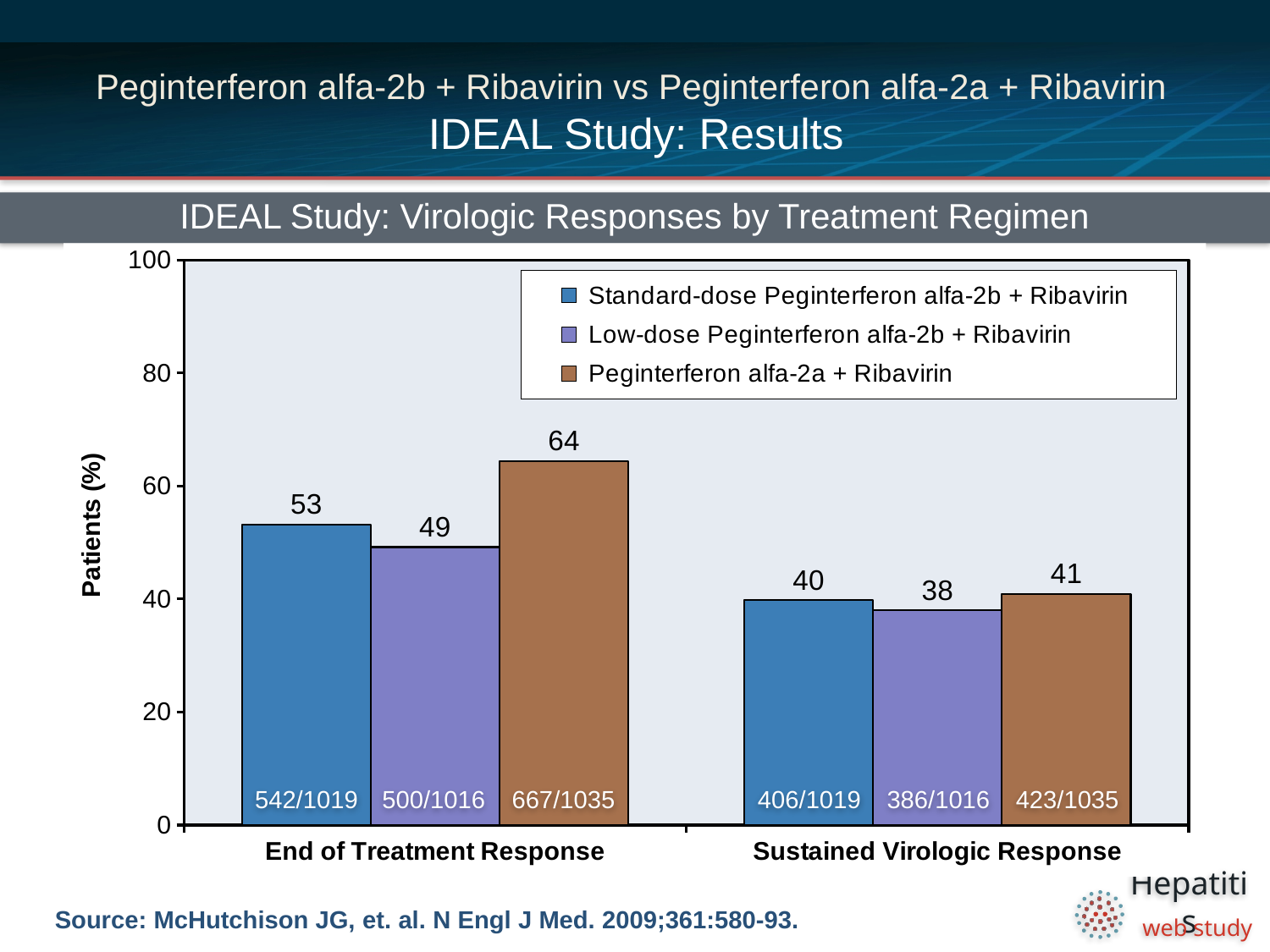
What is the Sustained Virologic Response value for Low-dose Peginterferon alfa-2b + Ribavirin? 38 How many series does the legend list? 3 Which is larger: the End of Treatment Response for Standard-dose Peginterferon alfa-2b + Ribavirin or for Low-dose Peginterferon alfa-2b + Ribavirin? Standard-dose Peginterferon alfa-2b + Ribavirin What is the label of the y axis? Patients (%) What kind of chart is shown on the slide? Bar chart Which treatment regimen has the lowest Sustained Virologic Response? Low-dose Peginterferon alfa-2b + Ribavirin How many categories are shown on the x axis? 2 Which treatment regimen has the highest End of Treatment Response? Peginterferon alfa-2a + Ribavirin Is the End of Treatment Response for Peginterferon alfa-2a + Ribavirin greater or less than 60? greater What is the difference between the End of Treatment Response for Peginterferon alfa-2a + Ribavirin and for Standard-dose Peginterferon alfa-2b + Ribavirin? 11 What is the Sustained Virologic Response value for Peginterferon alfa-2a + Ribavirin? 41 What is the End of Treatment Response value for Standard-dose Peginterferon alfa-2b + Ribavirin? 53